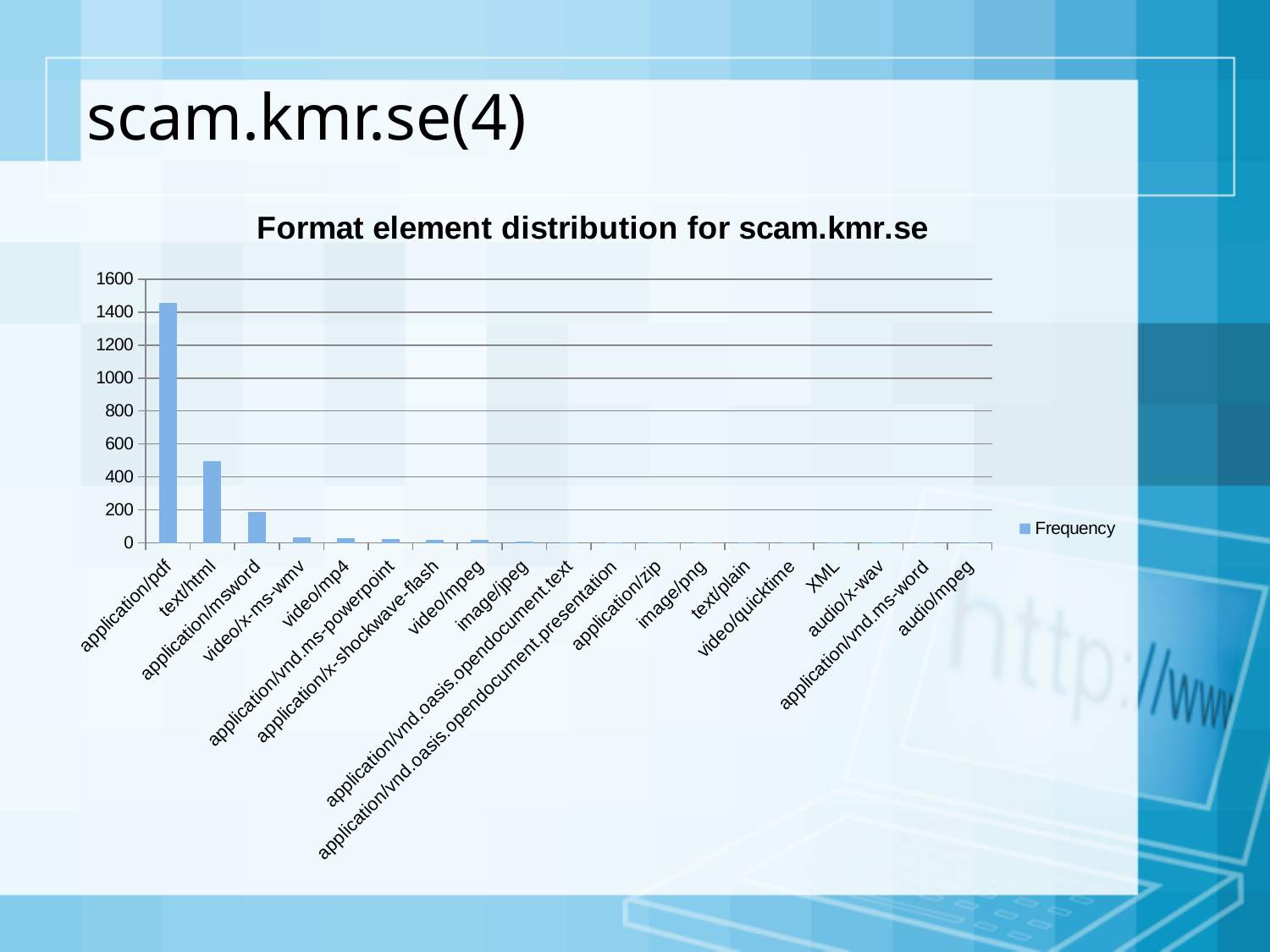
Which has a higher frequency, text/html or application/msword? text/html Is the frequency for application/pdf greater or less than 1200? greater What type of chart is shown on the slide? bar chart How many series does the legend list? 1 Is the frequency for text/html greater or less than 600? less What is the name of the series shown in the legend? Frequency Is the frequency for text/html greater or less than 400? greater How many format categories are shown on the x axis? 19 Which format has the highest frequency? application/pdf Do the frequencies generally rise or fall moving from left to right along the x axis? fall What is the title of the chart? Format element distribution for scam.kmr.se